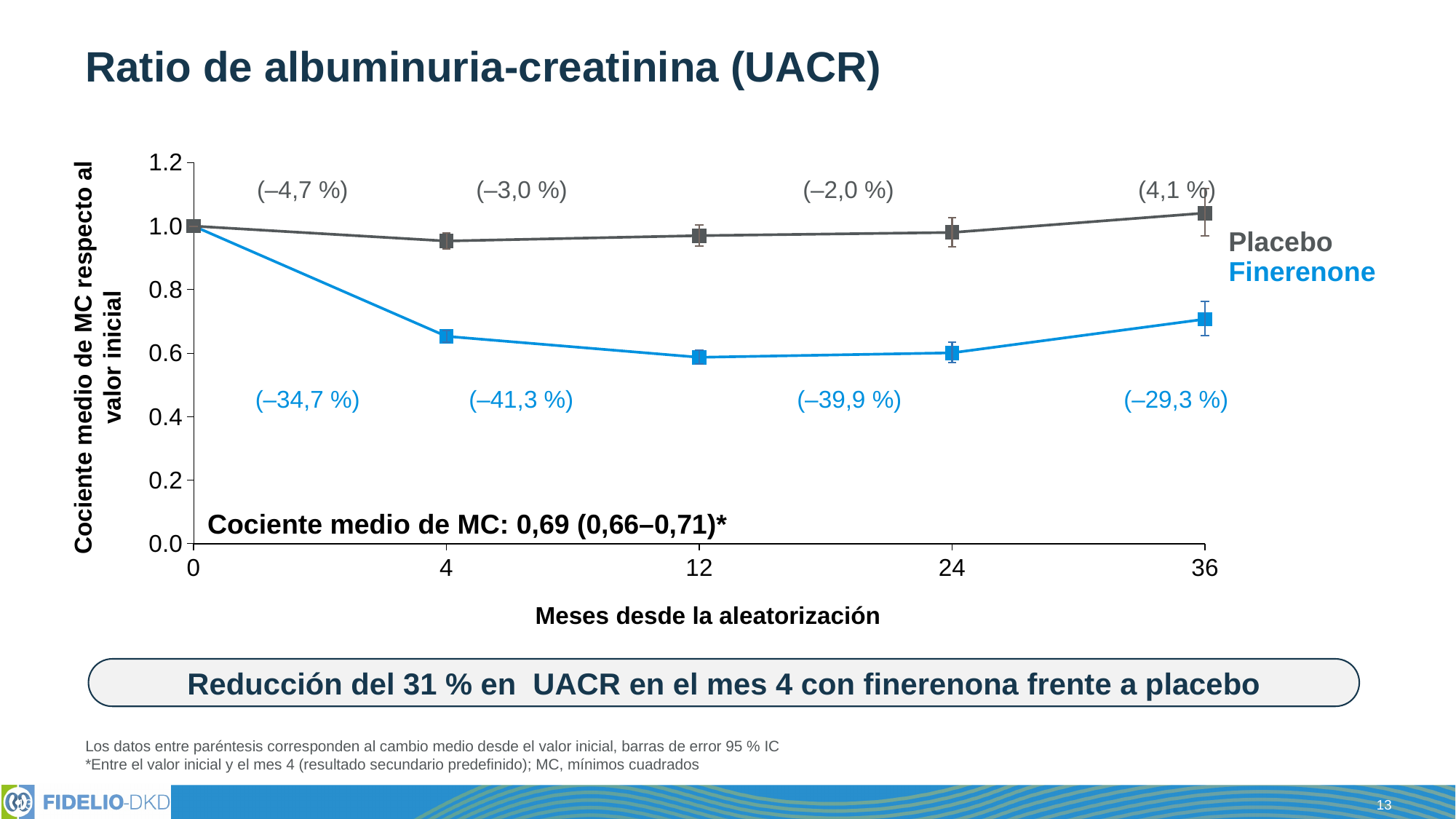
What is the lowest percent change label shown for the Finerenone series? –41,3 % What is the last percent change label shown for the Finerenone series (at month 36)? –29,3 % What LS mean ratio (Cociente medio de MC) is printed on the chart? 0,69 (0,66–0,71) Is the Placebo value at month 24 greater or less than 0.8? greater Is the Finerenone value at month 4 greater or less than 0.8? less What is the last percent change label shown for the Placebo series (at month 36)? 4,1 % What is the plotted value for Finerenone at month 0? 1.0 At month 36, which series has the higher value, Placebo or Finerenone? Placebo Does the Finerenone line rise or fall between month 0 and month 12? fall How many time points are marked on the x axis of the chart? 5 How many series does the chart show? 2 What kind of chart is shown on the slide? line chart